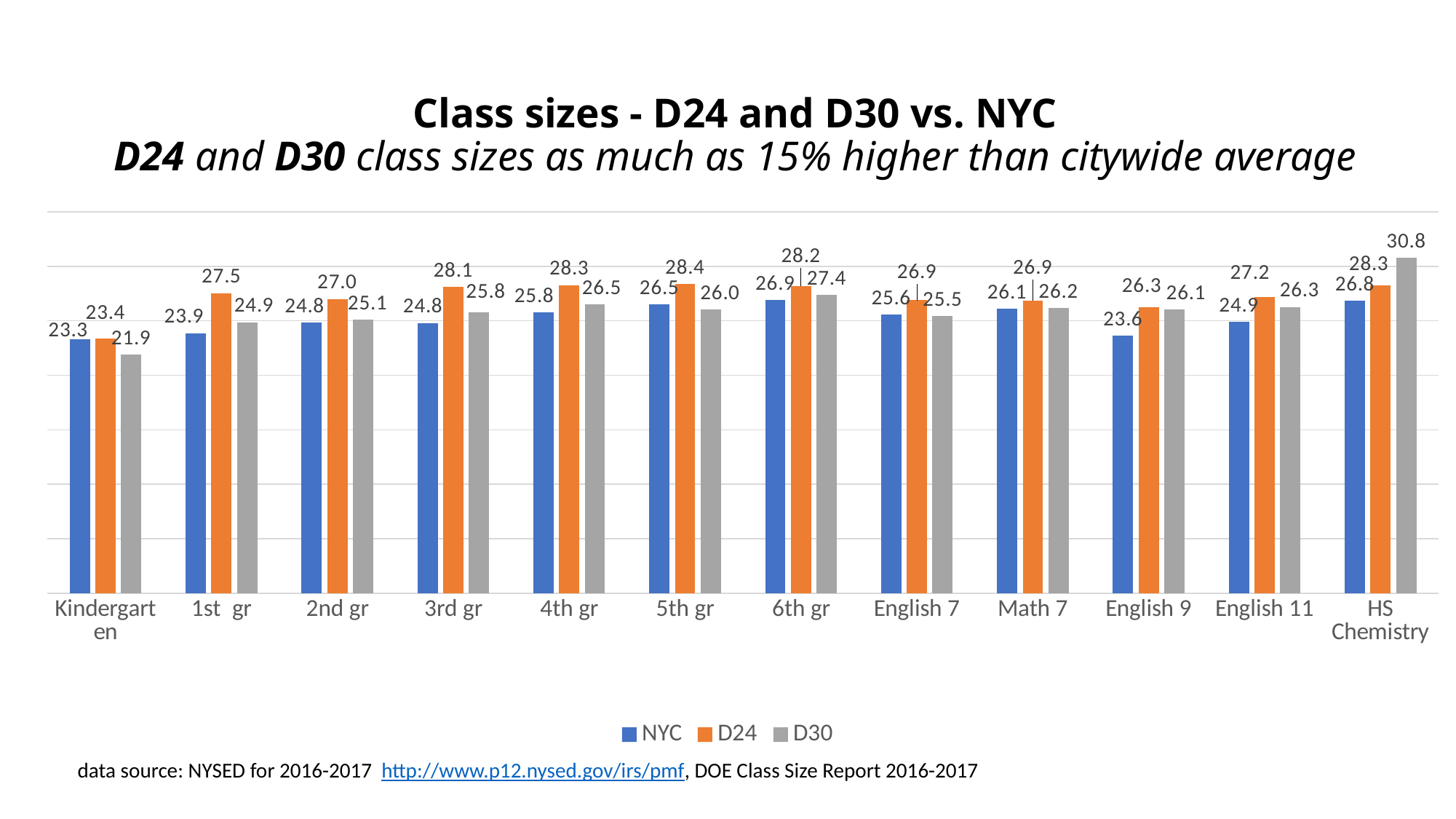
What is the difference between the D30 and NYC class sizes for HS Chemistry? 4.0 Which category has the highest D24 class size? 5th gr How many categories are shown on the x axis? 12 How many series does the legend list? 3 Which is larger for 5th gr, the NYC class size or the D30 class size? NYC What is the NYC class size for English 9? 23.6 Which category has the highest D30 class size? HS Chemistry What is the difference between the D24 and NYC class sizes for 3rd gr? 3.3 What kind of chart is shown on the slide? Bar chart Which category has the lowest D30 class size? Kindergarten What is the D30 class size for HS Chemistry? 30.8 What is the D24 class size for 1st gr? 27.5